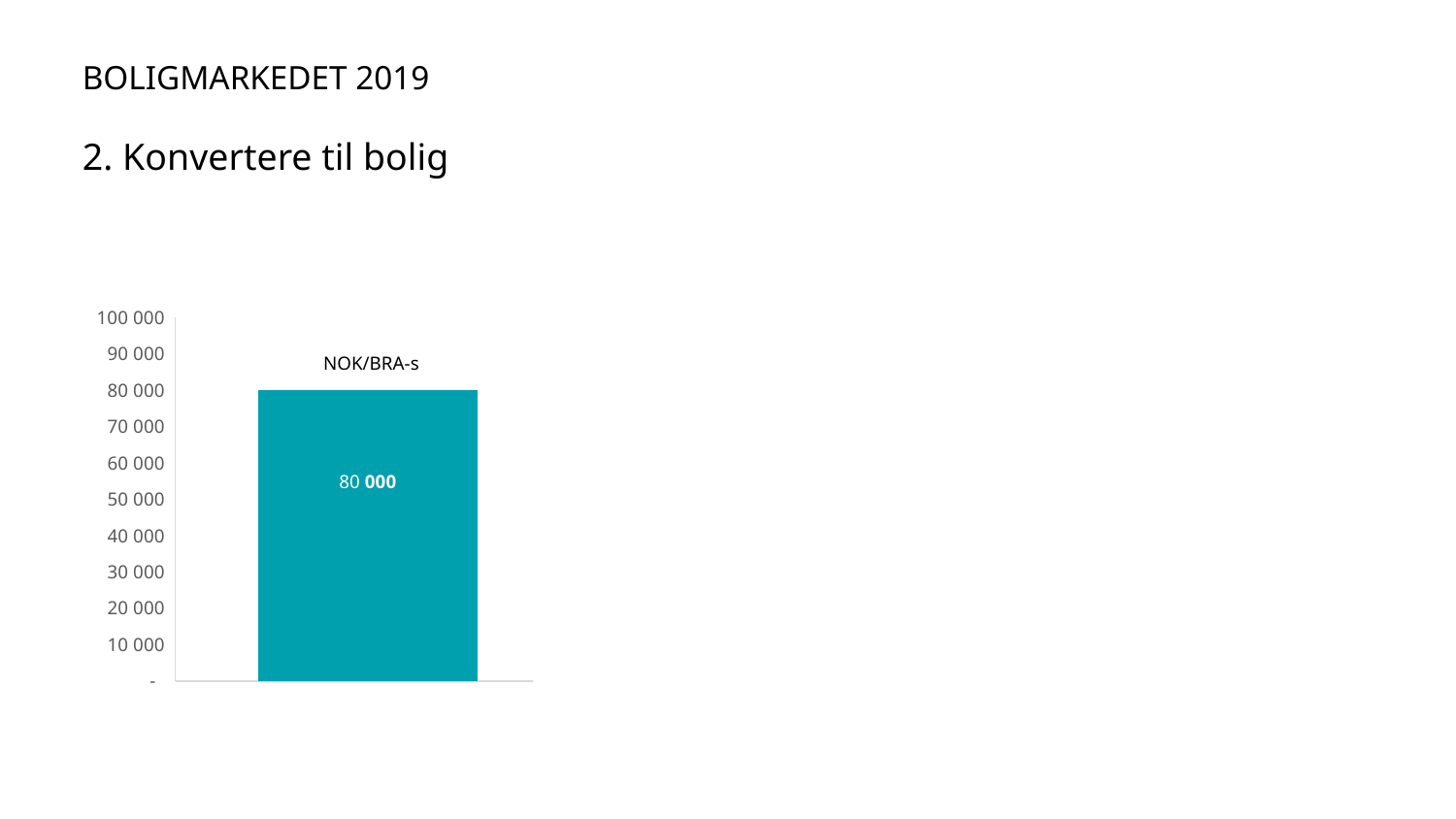
Is the value for NOK/BRA-s greater or less than 50 000? greater What is the highest value shown on the vertical axis? 100 000 How many bars does the chart contain? 1 What is the label of the bar in the chart? NOK/BRA-s What kind of chart is shown on the slide? bar chart What value is shown for the NOK/BRA-s bar? 80 000 Is the value for NOK/BRA-s greater or less than 90 000? less What is the difference between the top of the vertical axis (100 000) and the NOK/BRA-s value? 20 000